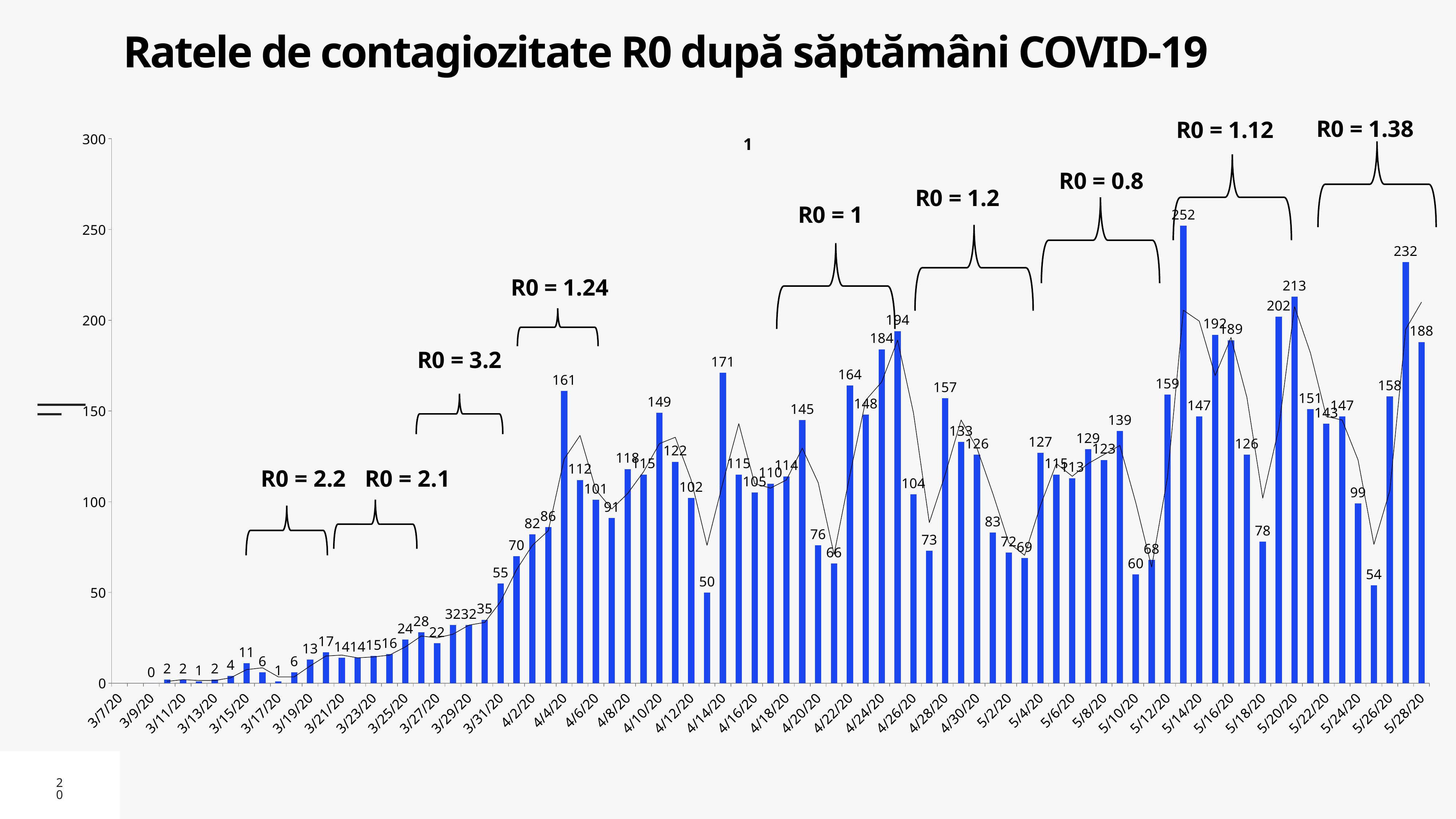
Do the values generally rise or fall from March to May along the x axis? rise What R0 value is annotated above the last bracket on the right of the chart? R0 = 1.38 Is the value for 5/28/20 greater or less than 150? greater What kind of chart is shown on the slide? bar chart What is the value of the second-tallest bar in the chart? 232 Is the tallest bar greater or less than 250? greater What is the value of the tallest bar in the chart? 252 What is the difference between the two tallest bars (252 and 232)? 20 What is the title of the chart? 1 What is the value for 5/28/20, the last date on the x axis? 188